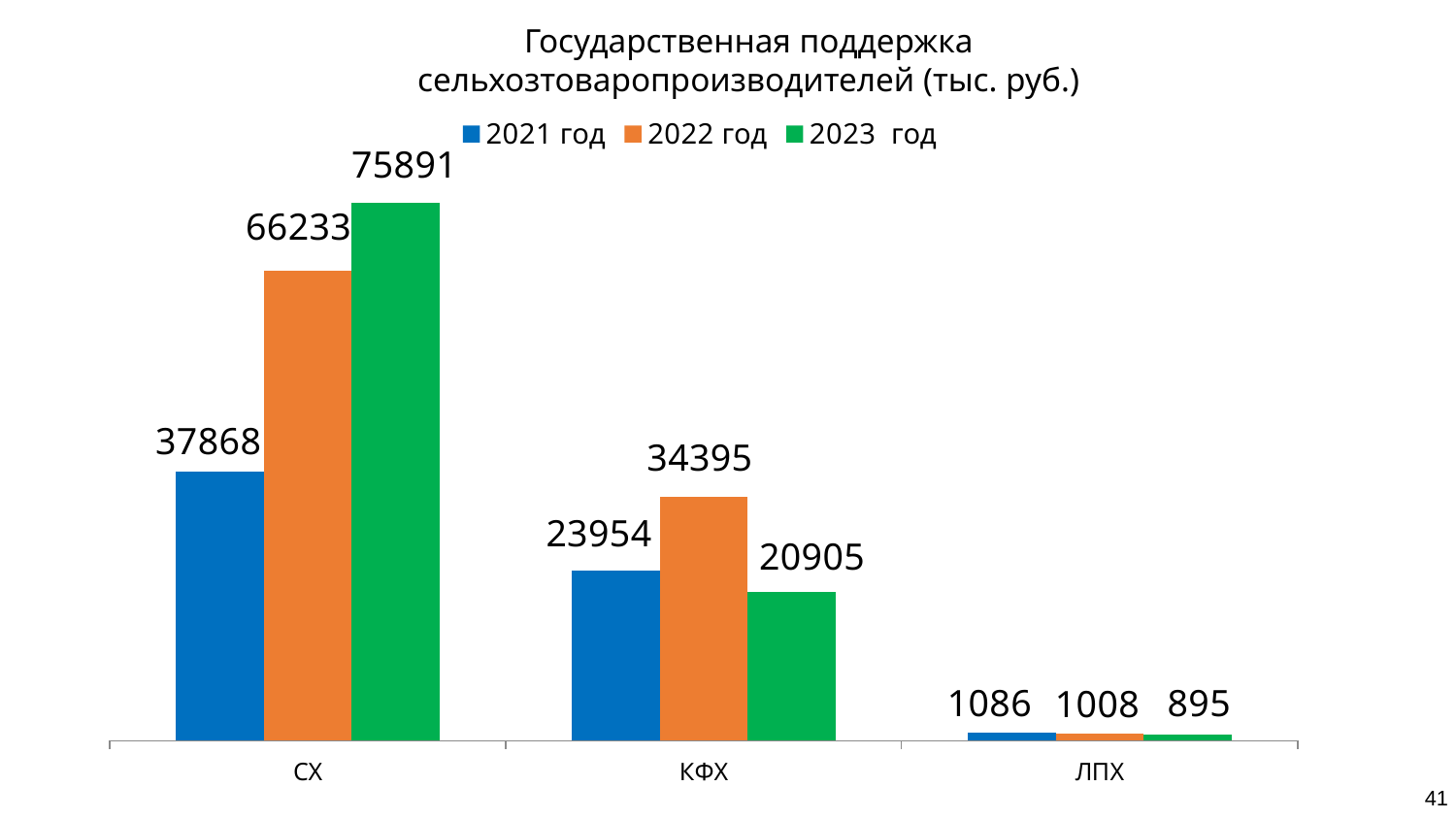
What is the value for КФХ in 2023 год? 20905 Which category has the highest value in 2023 год? СХ What is the value for СХ in 2021 год? 37868 What kind of chart is shown on the slide? Bar chart How many series does the legend list? 3 Which is larger for КФХ: the 2021 год value or the 2023 год value? 2021 год What is the difference between the 2022 год and 2023 год values for КФХ? 13490 What is the value for ЛПХ in 2022 год? 1008 Which category has the lowest value in 2021 год? ЛПХ How many categories are shown on the x axis? 3 What is the difference between the 2023 год and 2022 год values for СХ? 9658 Do the values for ЛПХ rise or fall from 2021 год to 2023 год? Fall